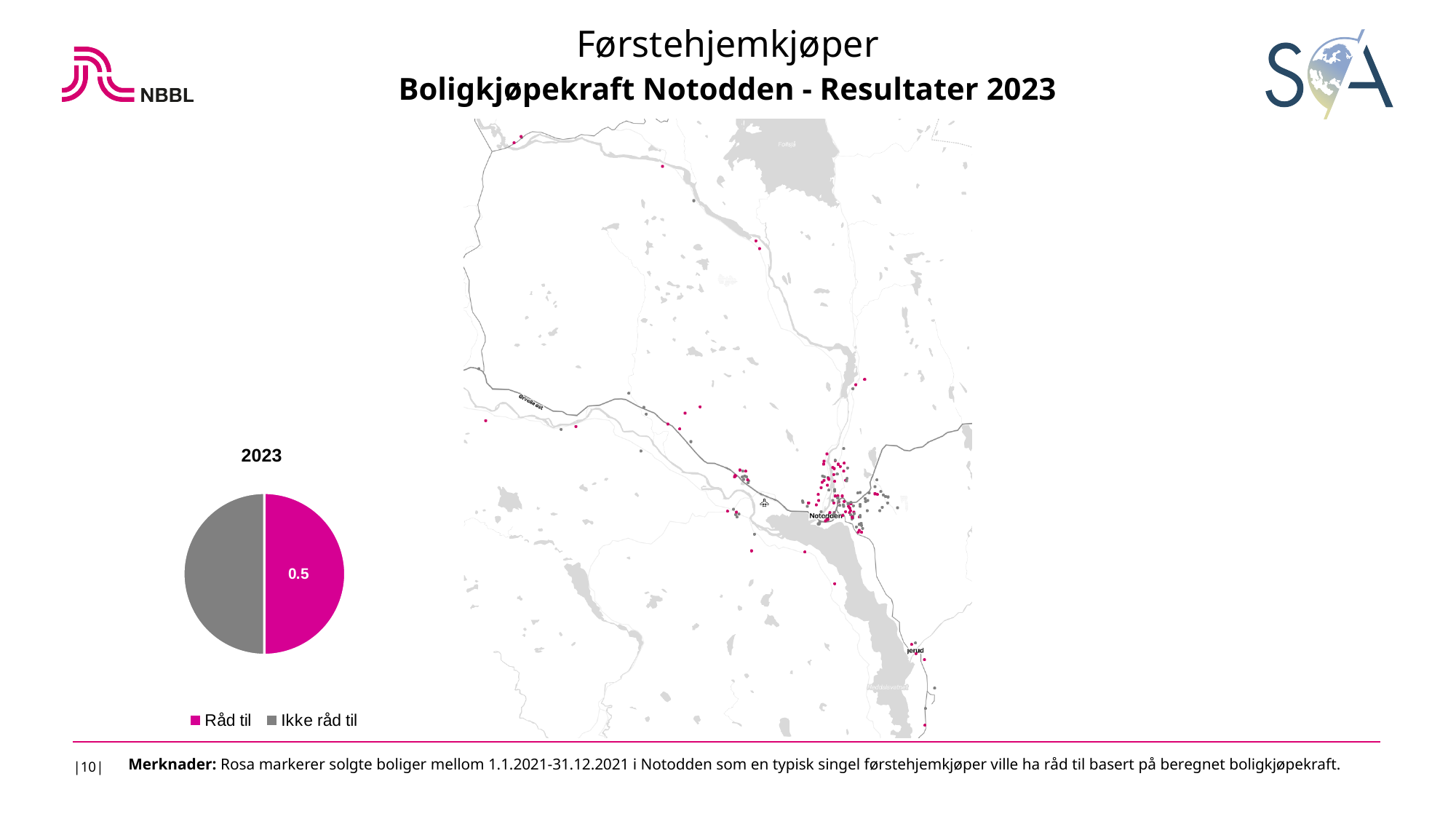
What value is printed on the 'Råd til' slice of the pie chart? 0.5 How many entries does the pie chart's legend list? 2 How many slices does the pie chart have? 2 Which legend entry is shown in pink in the pie chart? Råd til What share of the pie does the 'Råd til' slice represent, according to its data label? 0.5 What kind of chart is shown on the left of the slide? pie chart What is the title of the pie chart? 2023